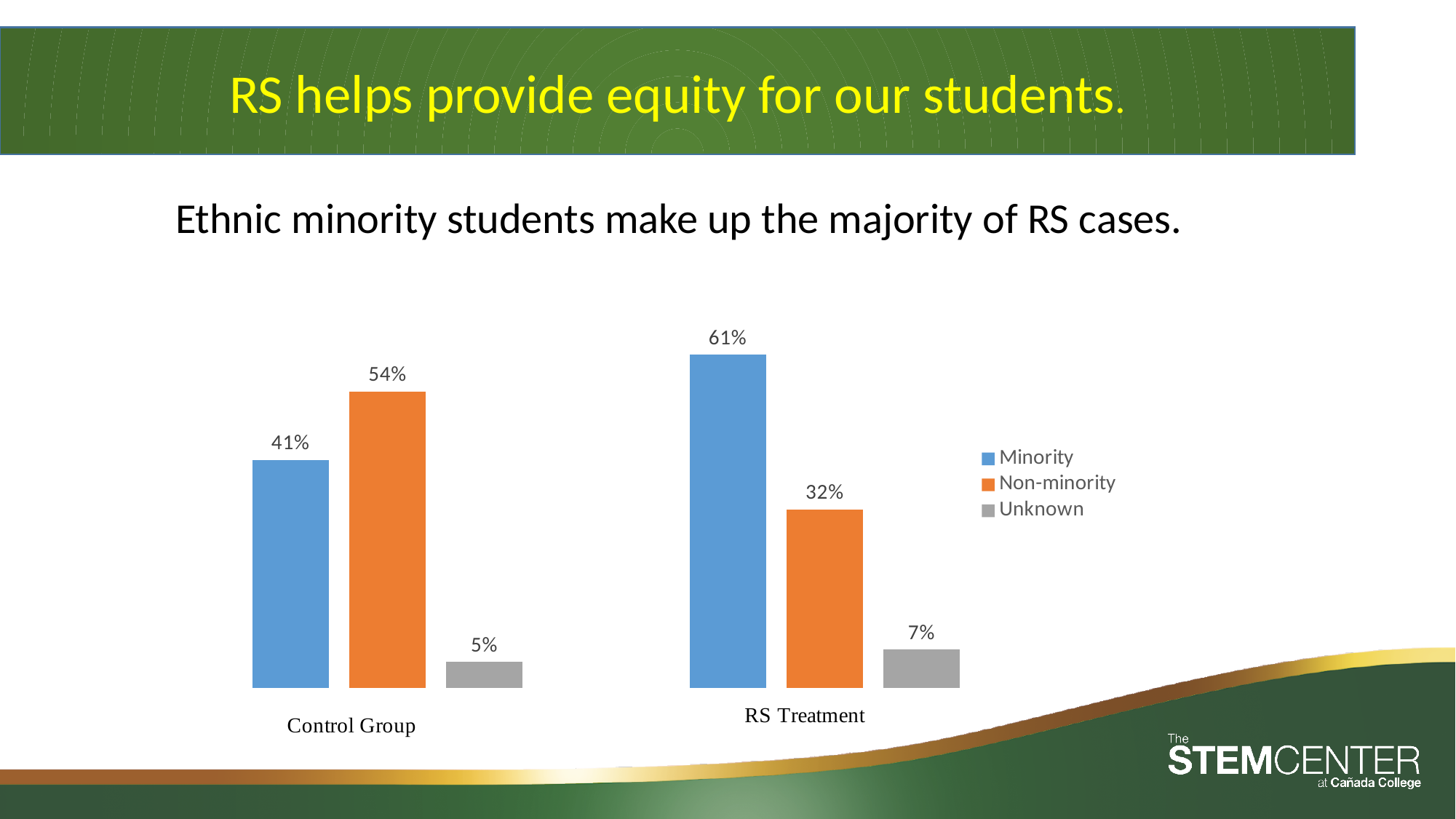
What kind of chart is shown on the slide? Bar chart What colour represents the Unknown series? Gray What is the difference between the Minority values for RS Treatment and Control Group? 20% What is the value for Unknown in the Control Group? 5% Which is larger in the Control Group, Minority or Non-minority? Non-minority How many categories are shown on the x axis? 2 Which series has the lowest value in the Control Group? Unknown Which series has the highest value in the RS Treatment group? Minority What is the value for Minority in the Control Group? 41% What is the value for Non-minority in the RS Treatment group? 32% How many series does the legend list? 3 What is the difference between Non-minority and Minority in the Control Group? 13%